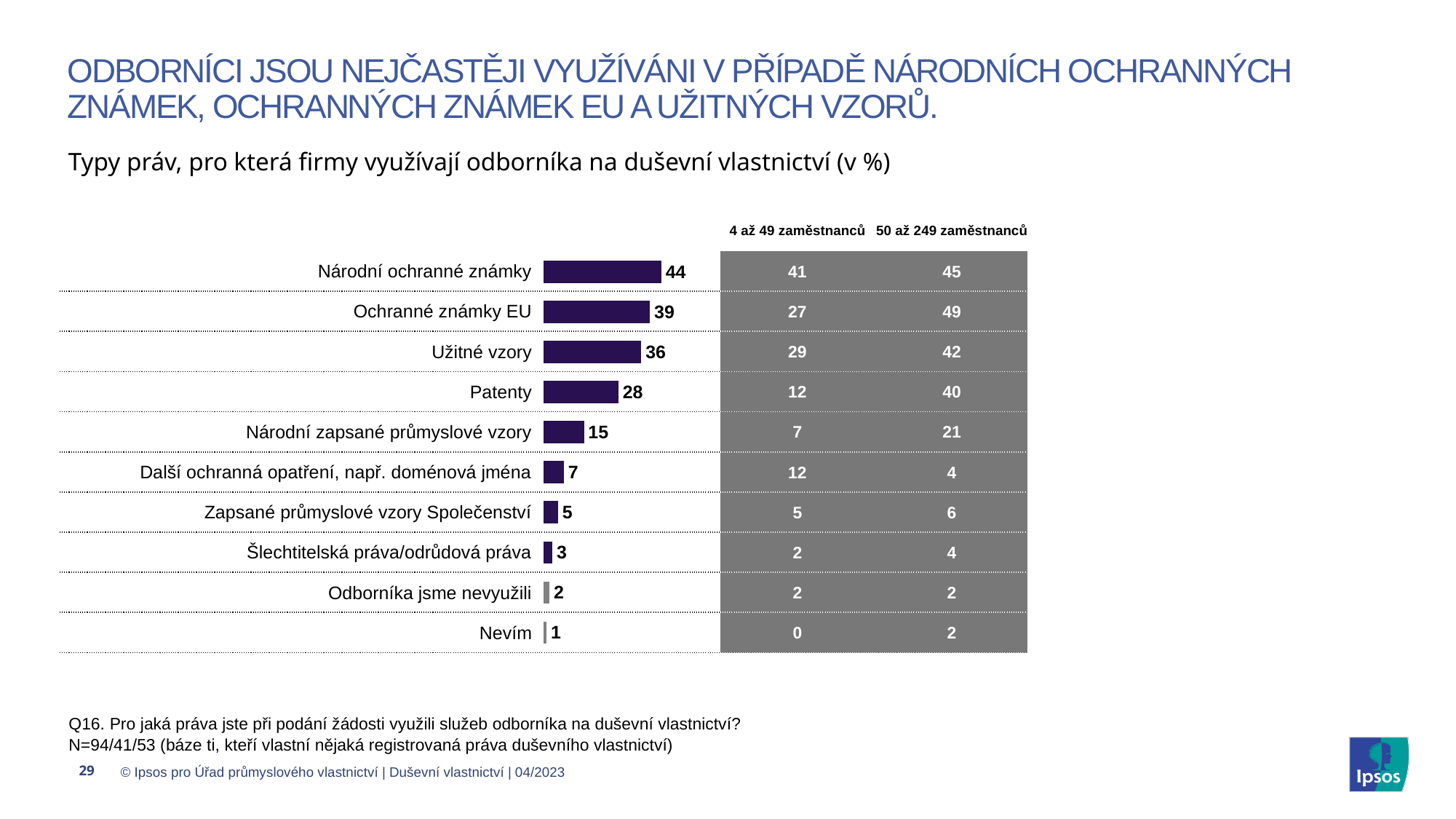
Which category has the lowest value in the bar chart? Nevím What is the difference between the values for Národní ochranné známky and Užitné vzory in the bar chart? 8 In the table next to the chart, what is the value for Patenty in the column 4 až 49 zaměstnanců? 12 In the table next to the chart, what is the value for Ochranné známky EU in the column 50 až 249 zaměstnanců? 49 What is the value for Národní zapsané průmyslové vzory in the bar chart? 15 Which is larger in the bar chart: the value for Patenty or the value for Užitné vzory? Užitné vzory Which category has the highest value in the bar chart? Národní ochranné známky How many categories are shown in the bar chart? 10 What is the value for Patenty in the bar chart? 28 What is the value for Ochranné známky EU in the bar chart? 39 What kind of chart is shown on the slide? Bar chart What is the subtitle describing the chart on the slide? Typy práv, pro která firmy využívají odborníka na duševní vlastnictví (v %)